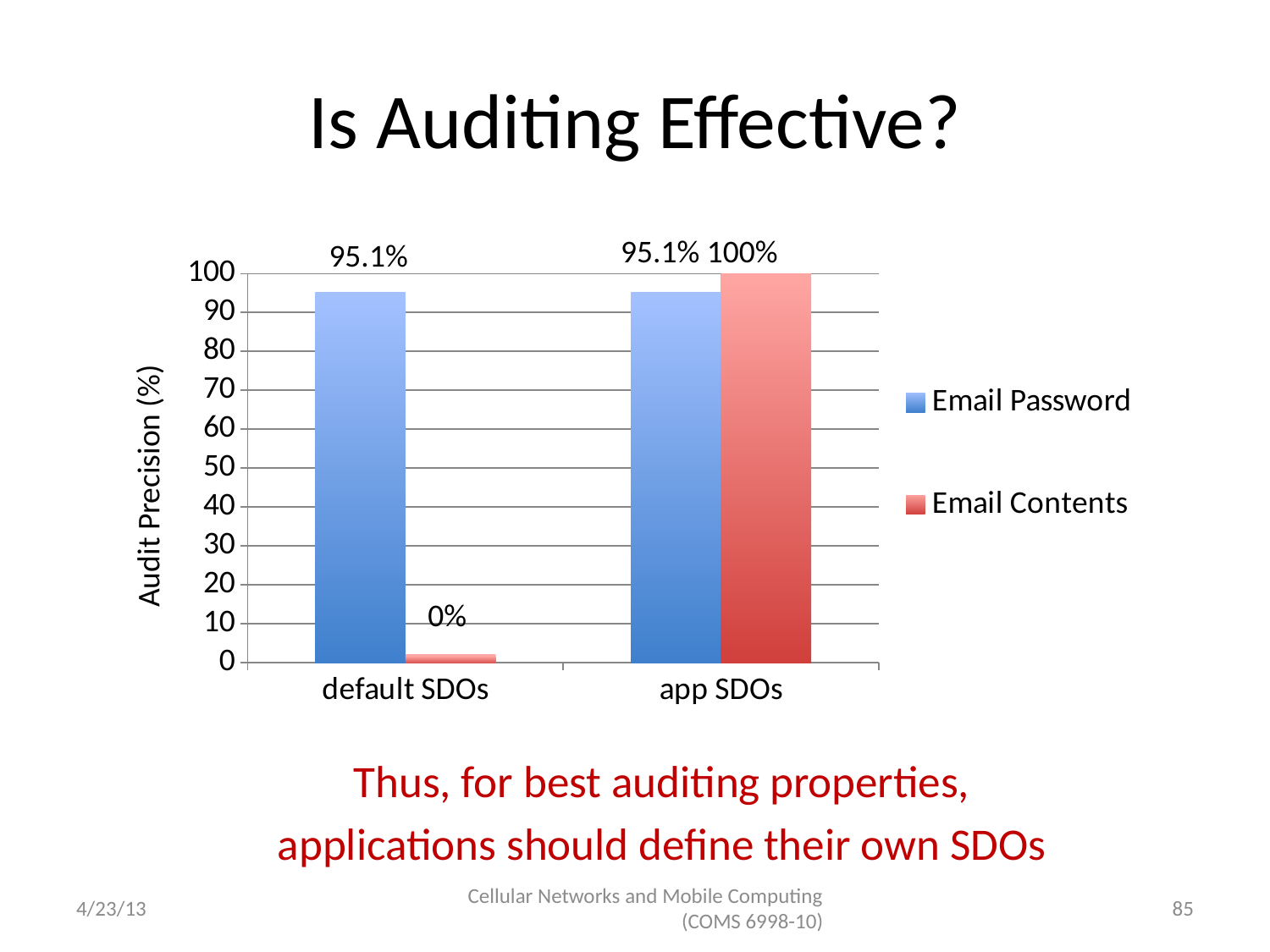
What is the audit precision for Email Contents with default SDOs? 0% How many categories are shown on the x axis? 2 What is the audit precision for Email Contents with app SDOs? 100% What is the audit precision for Email Password with default SDOs? 95.1% Which series has the lowest value for default SDOs? Email Contents How many series does the legend list? 2 What is the label of the y axis? Audit Precision (%) Which series has the highest value for app SDOs? Email Contents What is the audit precision for Email Password with app SDOs? 95.1% For app SDOs, which is larger: Email Password or Email Contents? Email Contents What is the difference between the Email Contents values for app SDOs and default SDOs? 100% What kind of chart is shown on the slide? Bar chart